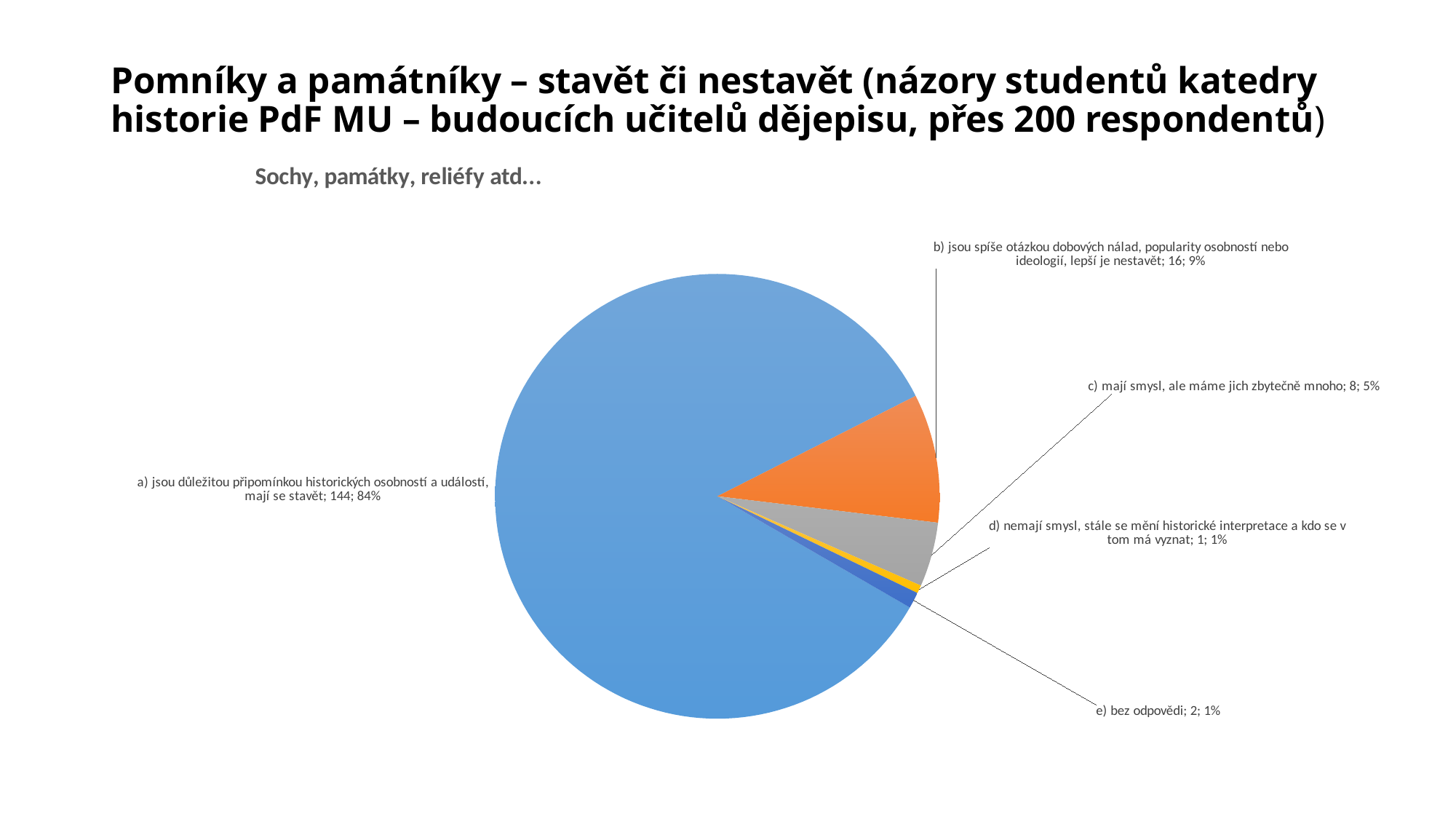
How many respondents chose option b) jsou spíše otázkou dobových nálad, popularity osobností nebo ideologií, lepší je nestavět? 16 What is the total number of respondents across all five slices of the pie? 171 How many respondents chose option a) jsou důležitou připomínkou historických osobností a událostí, mají se stavět? 144 How many slices does the pie chart have? 5 What share of the pie does option a) jsou důležitou připomínkou historických osobností a událostí, mají se stavět represent? 84% What is the difference in respondent counts between option a) (144) and option b) (16)? 128 Which option has the smallest number of respondents? d) nemají smysl, stále se mění historické interpretace a kdo se v tom má vyznat What kind of chart is shown on the slide? pie chart What is the title of the chart? Sochy, památky, reliéfy atd... Which option has the largest slice of the pie? a) jsou důležitou připomínkou historických osobností a událostí, mají se stavět Which has more respondents: option c) mají smysl, ale máme jich zbytečně mnoho or option e) bez odpovědi? c) mají smysl, ale máme jich zbytečně mnoho What percentage is shown for option c) mají smysl, ale máme jich zbytečně mnoho? 5%